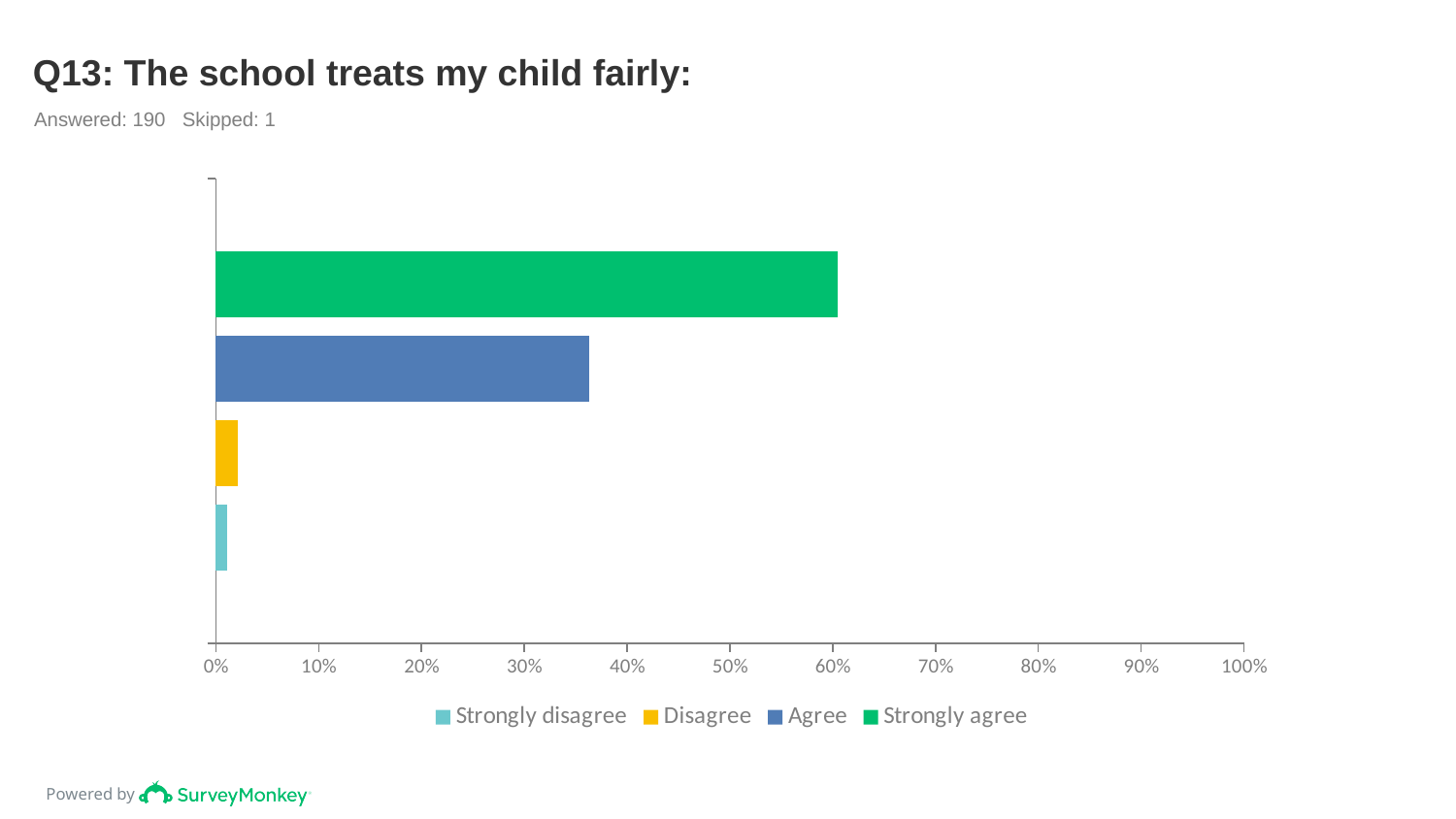
How many series does the legend list? 4 How many bars are plotted in the chart? 4 Which response option has the lowest value? Strongly disagree What kind of chart is shown on the slide? bar chart Is the value for Agree greater or less than 40%? less Is the value for Strongly agree greater or less than 50%? greater Is the value for Agree greater or less than 30%? greater Which response option has the highest value? Strongly agree What is the title of the chart? Q13: The school treats my child fairly: Which is larger, the value for Agree or the value for Strongly agree? Strongly agree Which is larger, the value for Disagree or the value for Agree? Agree